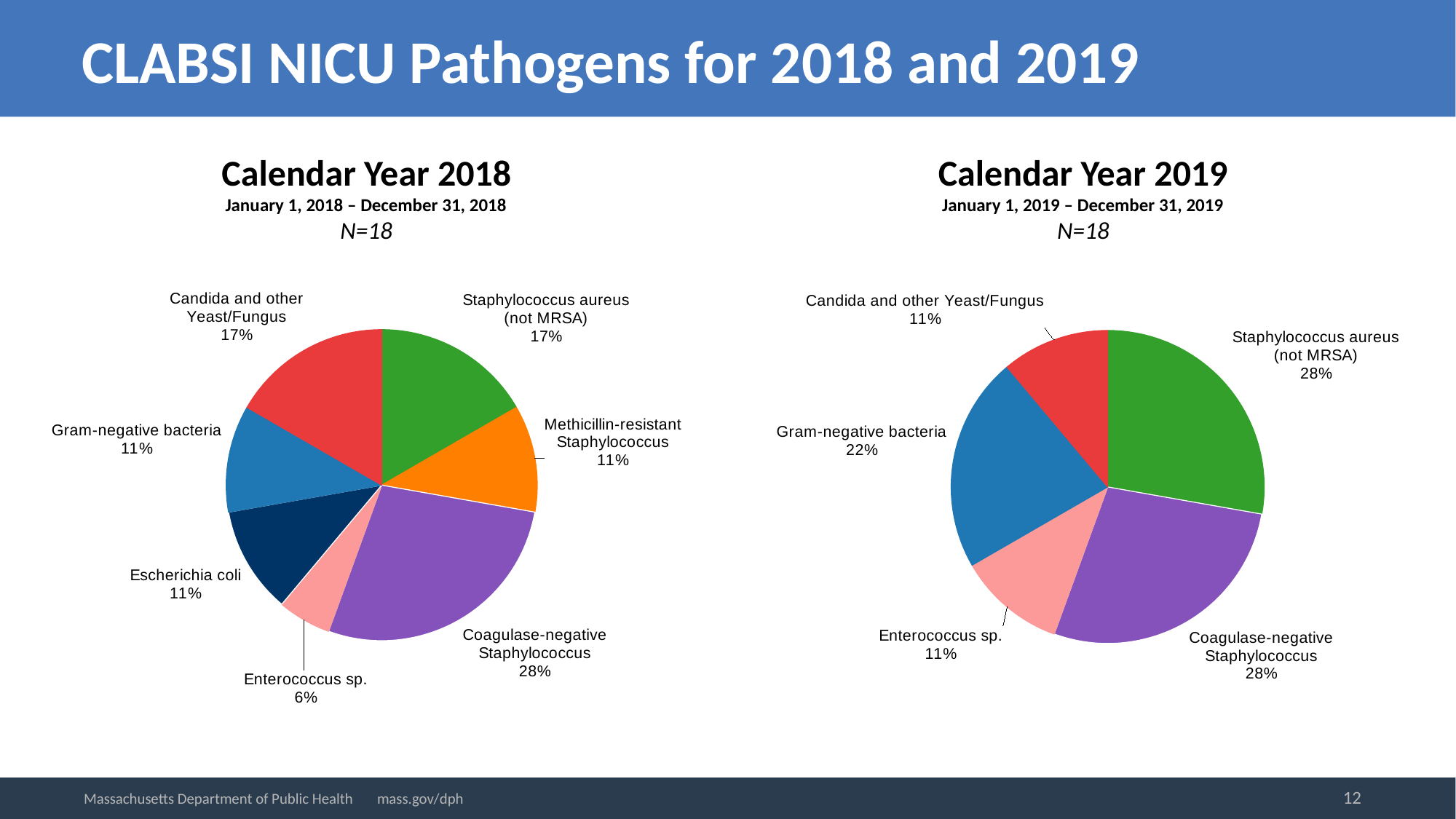
In the Calendar Year 2018 chart, what share of pathogens is Coagulase-negative Staphylococcus? 28% In the Calendar Year 2019 chart, which is larger: Gram-negative bacteria or Enterococcus sp.? Gram-negative bacteria In the Calendar Year 2018 chart, which pathogen category has the largest share? Coagulase-negative Staphylococcus What is the N value shown for the Calendar Year 2018 chart? N=18 How many pathogen categories are shown in the Calendar Year 2019 pie chart? 5 In the Calendar Year 2019 chart, what share is Candida and other Yeast/Fungus? 11% In the Calendar Year 2019 chart, what percentage is Gram-negative bacteria? 22% What type of chart is used for Calendar Year 2019? Pie chart In the Calendar Year 2018 chart, what is the difference between the shares of Coagulase-negative Staphylococcus and Staphylococcus aureus (not MRSA)? 11% In the Calendar Year 2018 chart, which pathogen category has the smallest share? Enterococcus sp. How many pathogen categories are shown in the Calendar Year 2018 pie chart? 7 In the Calendar Year 2018 chart, what percentage is Enterococcus sp.? 6%